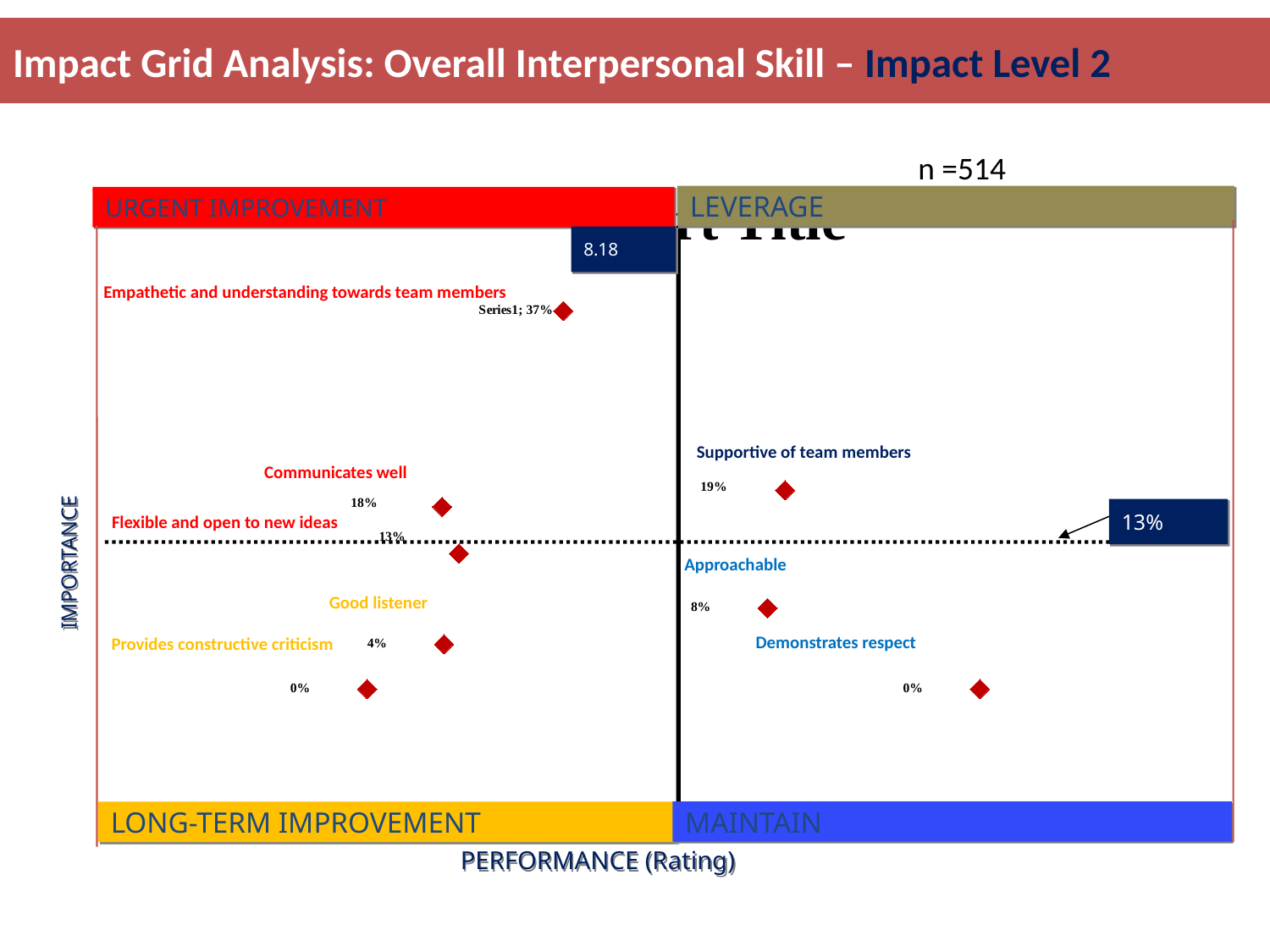
What is the value labelled for 'Flexible and open to new ideas'? 13% What is the value labelled for 'Communicates well'? 18% Which item has the highest labelled value on the grid? Empathetic and understanding towards team members What is the value labelled for 'Empathetic and understanding towards team members'? 37% How many labelled data points are plotted on the grid? 8 What is the value labelled for 'Approachable'? 8% What is the value labelled for 'Supportive of team members'? 19% Which has the larger value, 'Supportive of team members' or 'Approachable'? Supportive of team members What is the label of the horizontal axis of the grid? PERFORMANCE (Rating) What kind of chart is shown on the slide? scatter chart What is the difference between the values for 'Empathetic and understanding towards team members' and 'Communicates well'? 19% What is the value labelled for 'Good listener'? 4%